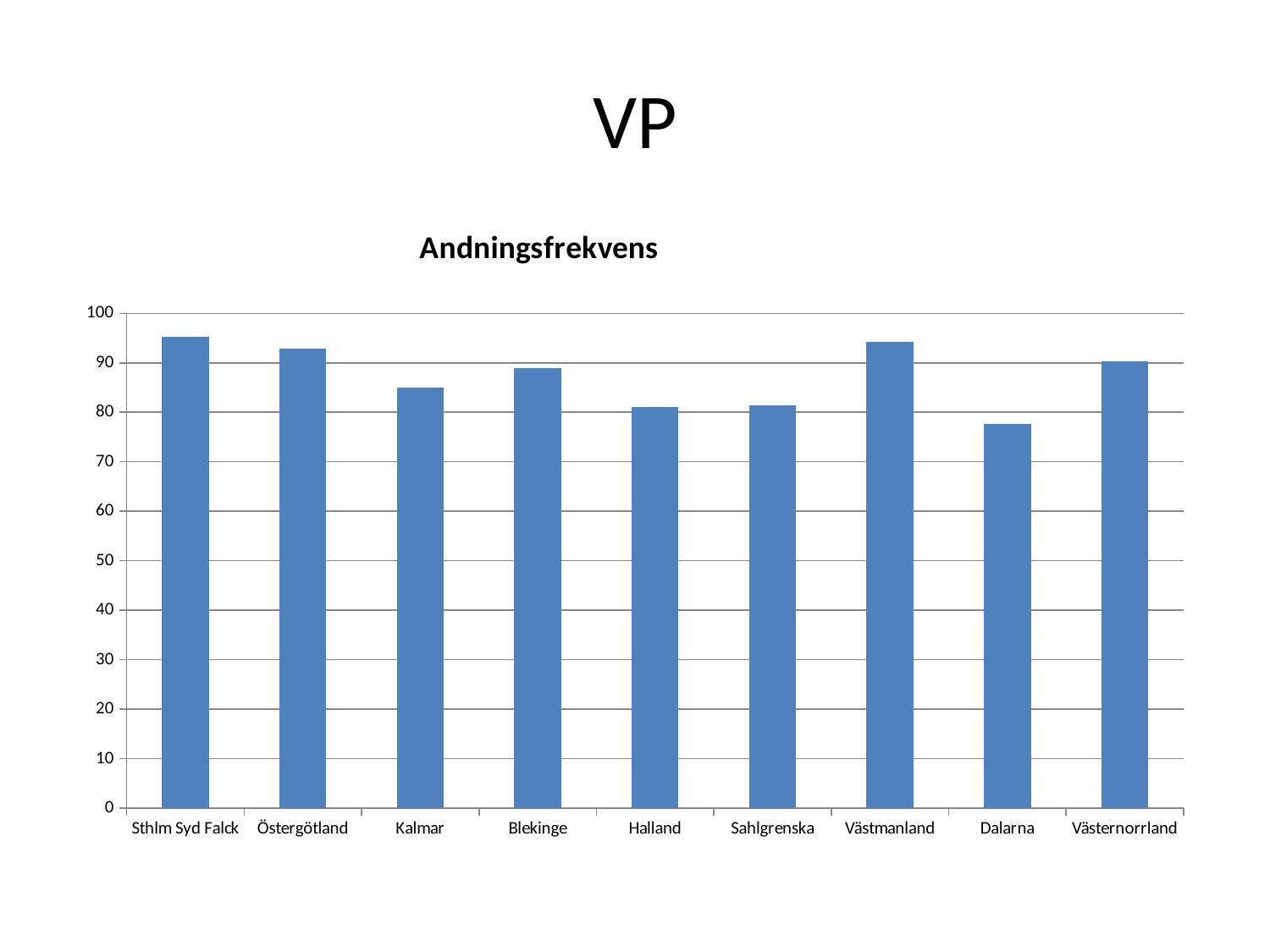
Which is larger, the value for Östergötland or the value for Blekinge? Östergötland What kind of chart is shown on the slide? bar chart Which is larger, the value for Dalarna or the value for Västmanland? Västmanland Is the value for Kalmar greater or less than 80? greater How many categories are shown on the x axis of the chart? 9 Which category has the lowest value in the chart? Dalarna Is the value for Halland greater or less than 90? less What is the title of the chart? Andningsfrekvens Which is larger, the value for Kalmar or the value for Halland? Kalmar Is the value for Östergötland greater or less than 90? greater